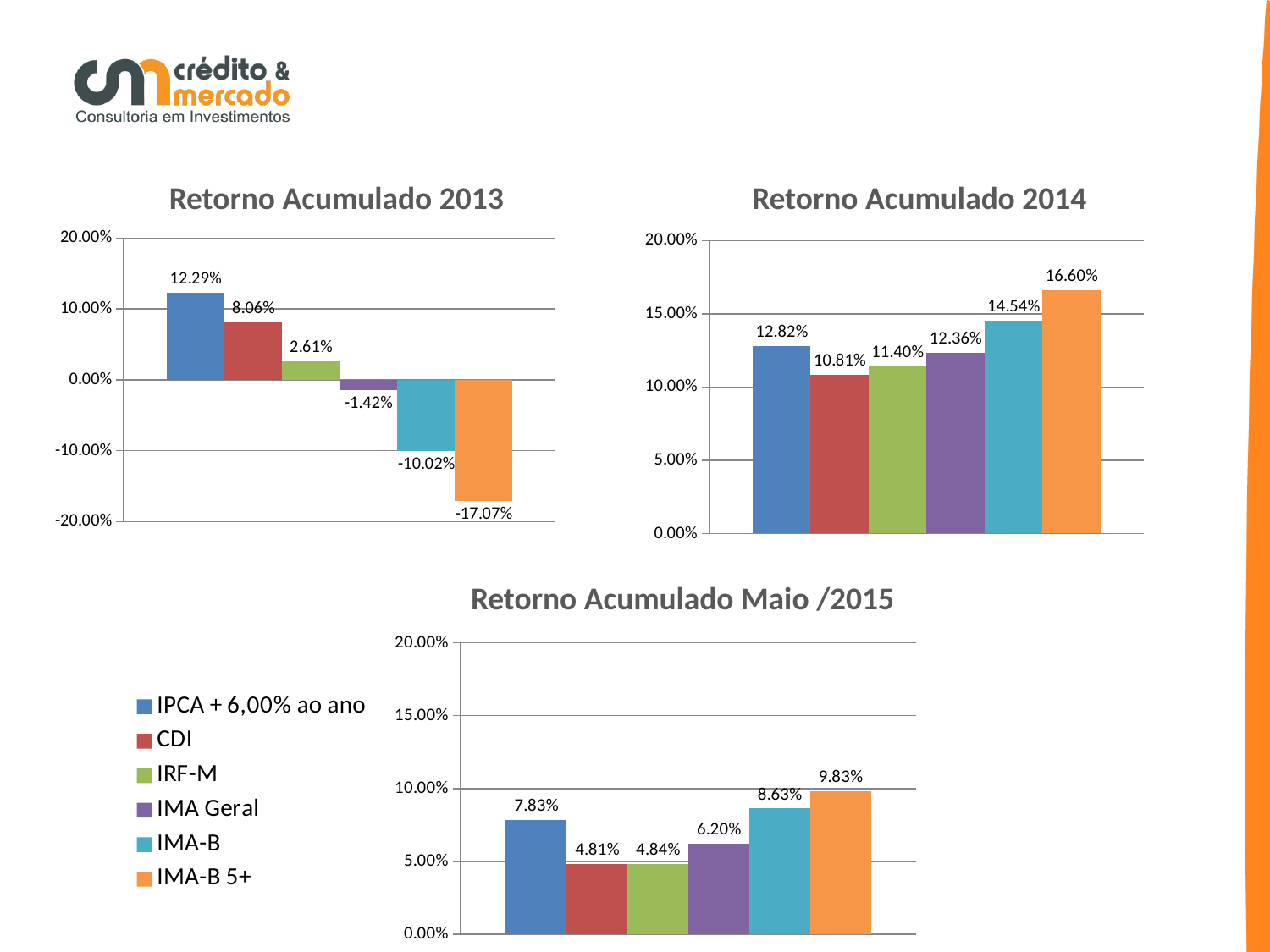
In the 'Retorno Acumulado 2014' chart, which series has the highest value? IMA-B 5+ In the 'Retorno Acumulado 2013' chart, do the values rise or fall from left to right? Fall In the 'Retorno Acumulado 2013' chart, what is the value of the IMA-B 5+ (orange) bar? -17.07% In the 'Retorno Acumulado 2014' chart, what is the value of the CDI (red) bar? 10.81% In the 'Retorno Acumulado 2013' chart, is the value for IMA-B greater or less than -10.00%? less In the 'Retorno Acumulado Maio /2015' chart, what is the difference between the IMA-B 5+ bar and the IPCA + 6,00% ao ano bar? 2.00% In the 'Retorno Acumulado 2013' chart, which series has the lowest value? IMA-B 5+ In the 'Retorno Acumulado Maio /2015' chart, what is the value of the IMA Geral (purple) bar? 6.20% How many bars are plotted in the 'Retorno Acumulado Maio /2015' chart? 6 How many series does the legend on the slide list? 6 What type of chart is 'Retorno Acumulado 2014'? Bar chart In the 'Retorno Acumulado 2014' chart, which is larger: the IRF-M bar or the IMA Geral bar? IMA Geral